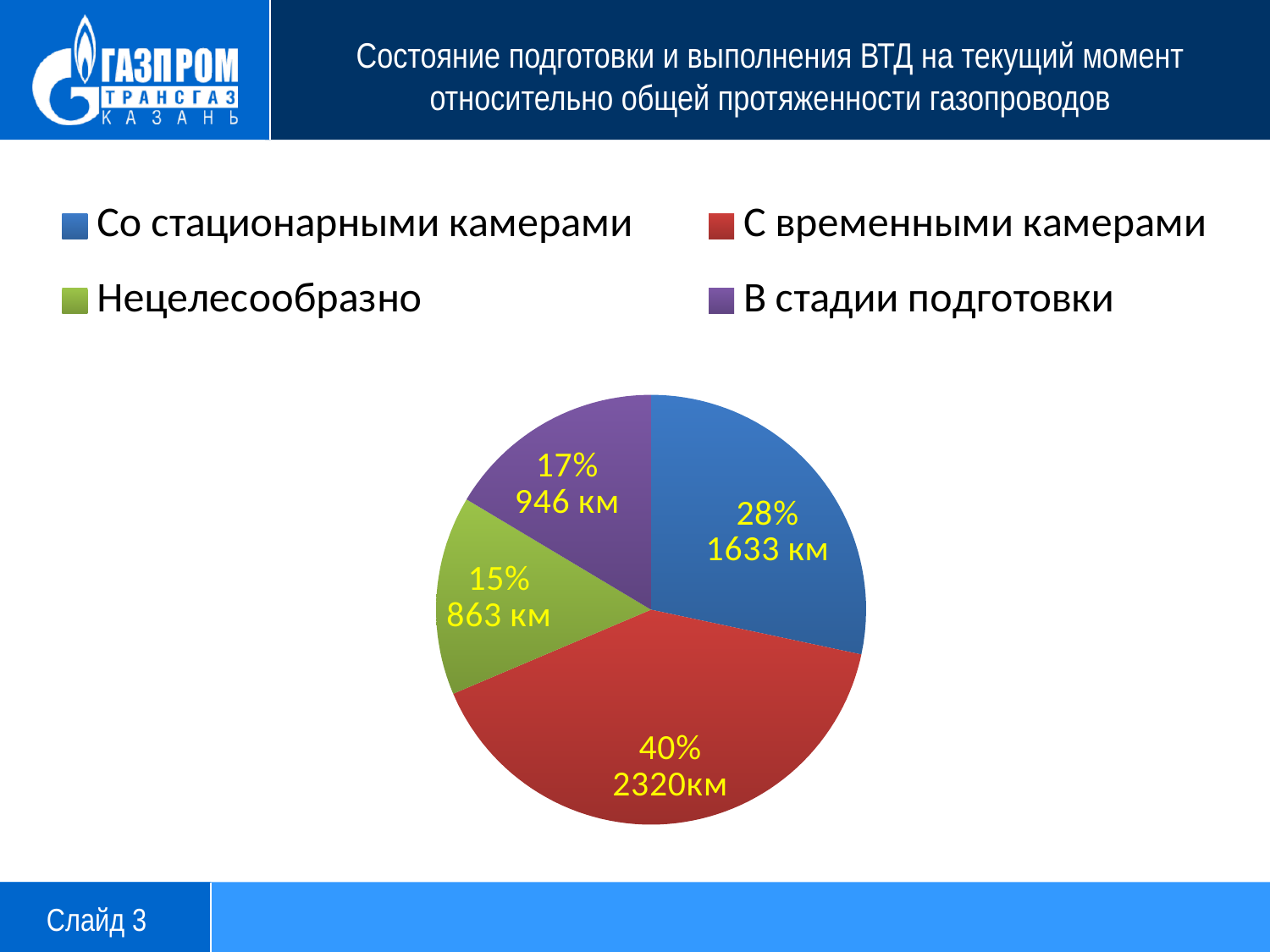
How many slices does the pie chart have? 4 Which category has the largest slice of the pie? С временными камерами Which is larger: the share for "В стадии подготовки" or the share for "Нецелесообразно"? В стадии подготовки What kind of chart is shown on the slide? pie chart What colour is the slice for "Со стационарными камерами"? blue What share of the pie does "В стадии подготовки" represent? 17% What is the difference in km between "С временными камерами" and "Со стационарными камерами"? 687 км How many entries does the legend list? 4 Which category has the smallest slice of the pie? Нецелесообразно What length in km is shown for "Нецелесообразно"? 863 км What length in km is shown for "Со стационарными камерами"? 1633 км What share of the pie does "С временными камерами" represent? 40%